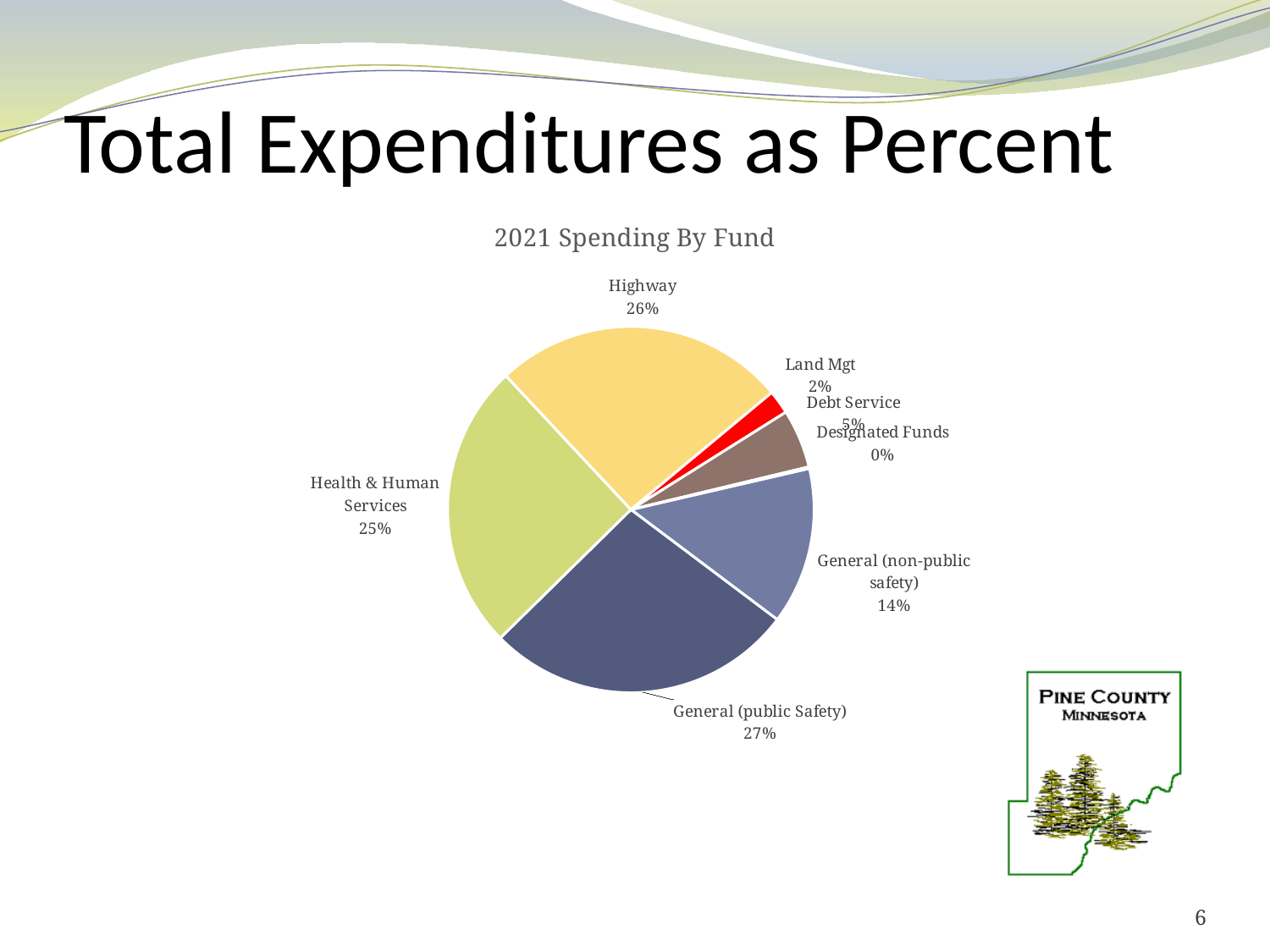
Which fund has the largest share of 2021 spending? General (public Safety) What percentage of 2021 spending goes to General (non-public safety)? 14% Which is larger, the share for Highway or the share for Health & Human Services? Highway What percentage of 2021 spending goes to Designated Funds? 0% What percentage of 2021 spending goes to Land Mgt? 2% What percentage of 2021 spending goes to Health & Human Services? 25% What type of chart is shown on the slide? pie chart Which fund has the smallest share of 2021 spending? Designated Funds What is the difference in percentage points between General (public Safety) and General (non-public safety)? 13 What is the title of the chart? 2021 Spending By Fund How many funds (slices) are shown in the pie chart? 7 What percentage of 2021 spending goes to Highway? 26%